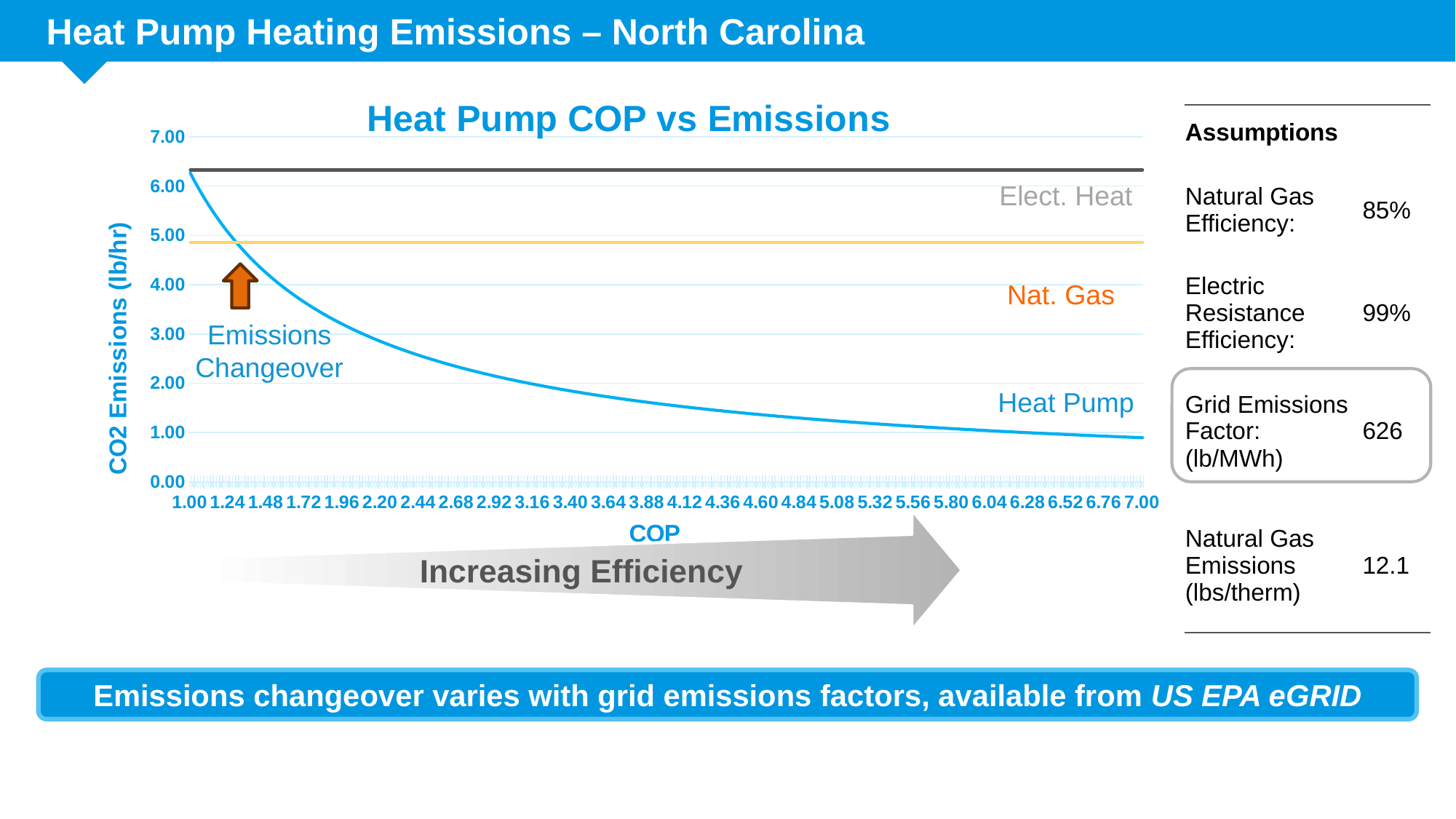
How many series are plotted on the chart? 3 Which series has the lowest emissions at COP 7.00? Heat Pump What is the label of the y axis? CO2 Emissions (lb/hr) What is the title of the chart? Heat Pump COP vs Emissions Which series has the highest emissions at COP 7.00? Elect. Heat What kind of chart is shown on the slide? line chart Is the Heat Pump value at COP 7.00 greater or less than 2.00? less Do the Heat Pump emissions rise or fall as COP increases along the x axis? fall Is the value for Nat. Gas greater or less than 4.00? greater Is the Heat Pump value at COP 1.00 greater or less than 6.00? greater At COP 4.12, which is larger: the Heat Pump value or the Nat. Gas value? Nat. Gas